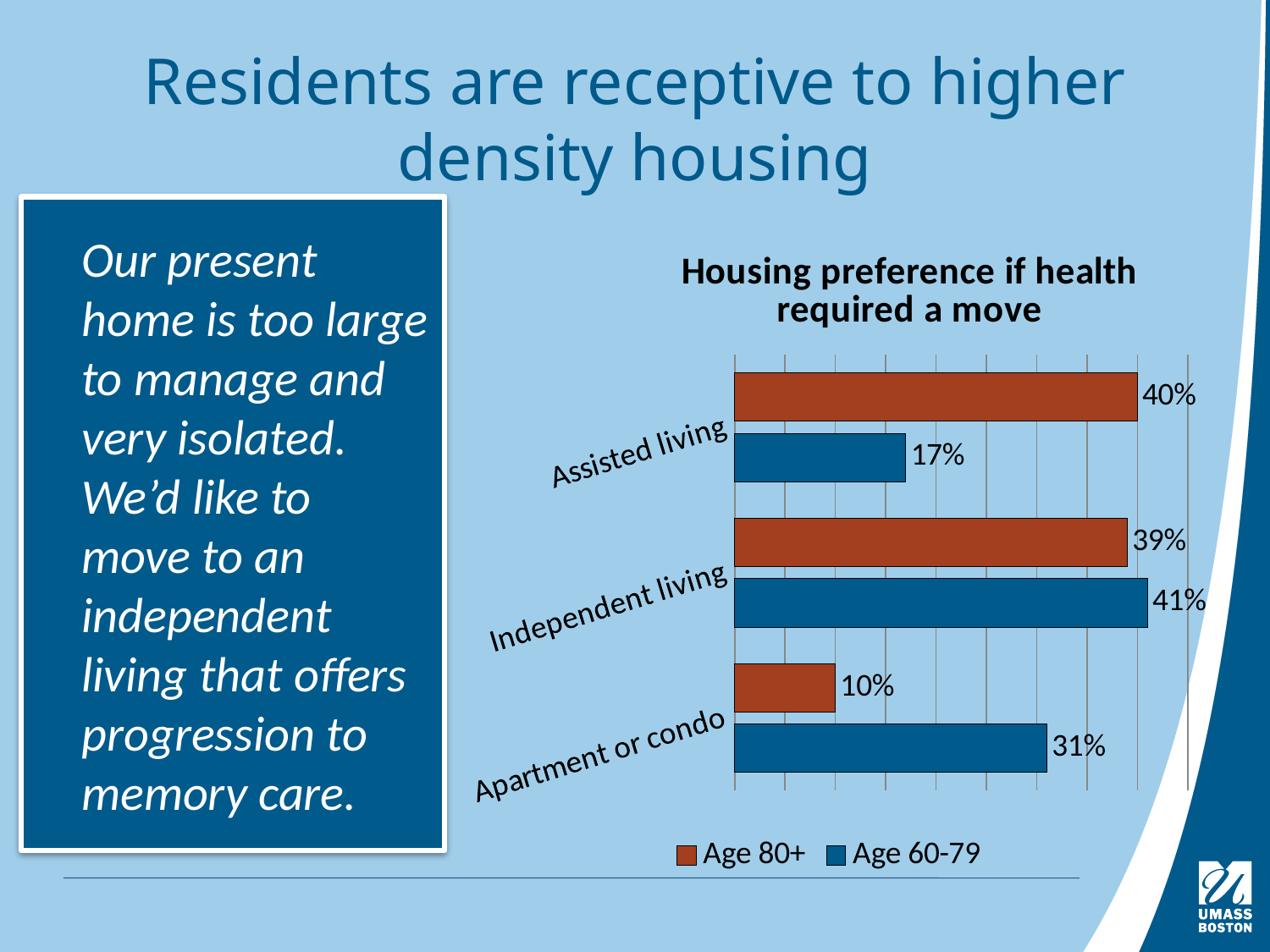
What is the difference between the Age 60-79 and Age 80+ values for Apartment or condo? 21% What is the difference between the Age 80+ and Age 60-79 values for Assisted living? 23% What kind of chart is shown on the slide? Bar chart Which category has the lowest value for Age 80+? Apartment or condo How many categories are shown on the chart? 3 What is the value for Age 80+ in the Assisted living category? 40% What is the title of the chart? Housing preference if health required a move Which category has the highest value for Age 60-79? Independent living What is the value for Age 60-79 in the Apartment or condo category? 31% How many series does the legend list? 2 What is the value for Age 60-79 in the Independent living category? 41% Which is larger for Assisted living: the Age 80+ value or the Age 60-79 value? Age 80+